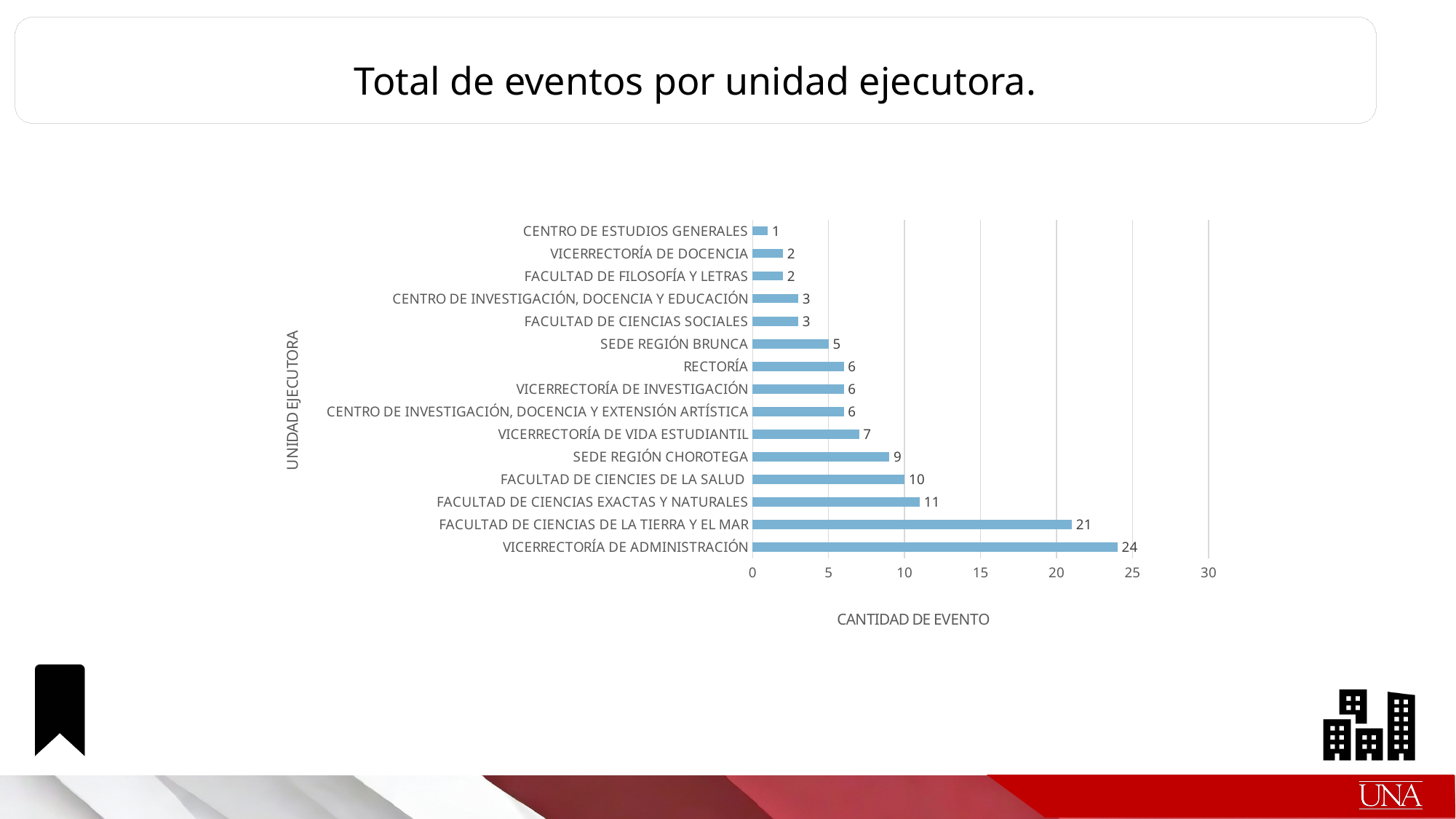
Is the value for VICERRECTORÍA DE VIDA ESTUDIANTIL greater or less than 5? greater Which is larger, FACULTAD DE CIENCIAS EXACTAS Y NATURALES or FACULTAD DE CIENCIES DE LA SALUD? FACULTAD DE CIENCIAS EXACTAS Y NATURALES What is the difference between VICERRECTORÍA DE ADMINISTRACIÓN and FACULTAD DE CIENCIAS DE LA TIERRA Y EL MAR? 3 What is the value for FACULTAD DE CIENCIAS DE LA TIERRA Y EL MAR? 21 What kind of chart is shown on the slide? bar chart What is the value for RECTORÍA? 6 Which unit has the lowest number of events? CENTRO DE ESTUDIOS GENERALES What is the value for SEDE REGIÓN CHOROTEGA? 9 What is the value for VICERRECTORÍA DE ADMINISTRACIÓN? 24 Which unit has the highest number of events? VICERRECTORÍA DE ADMINISTRACIÓN How many units are shown in the chart? 15 What is the label of the horizontal axis? CANTIDAD DE EVENTO